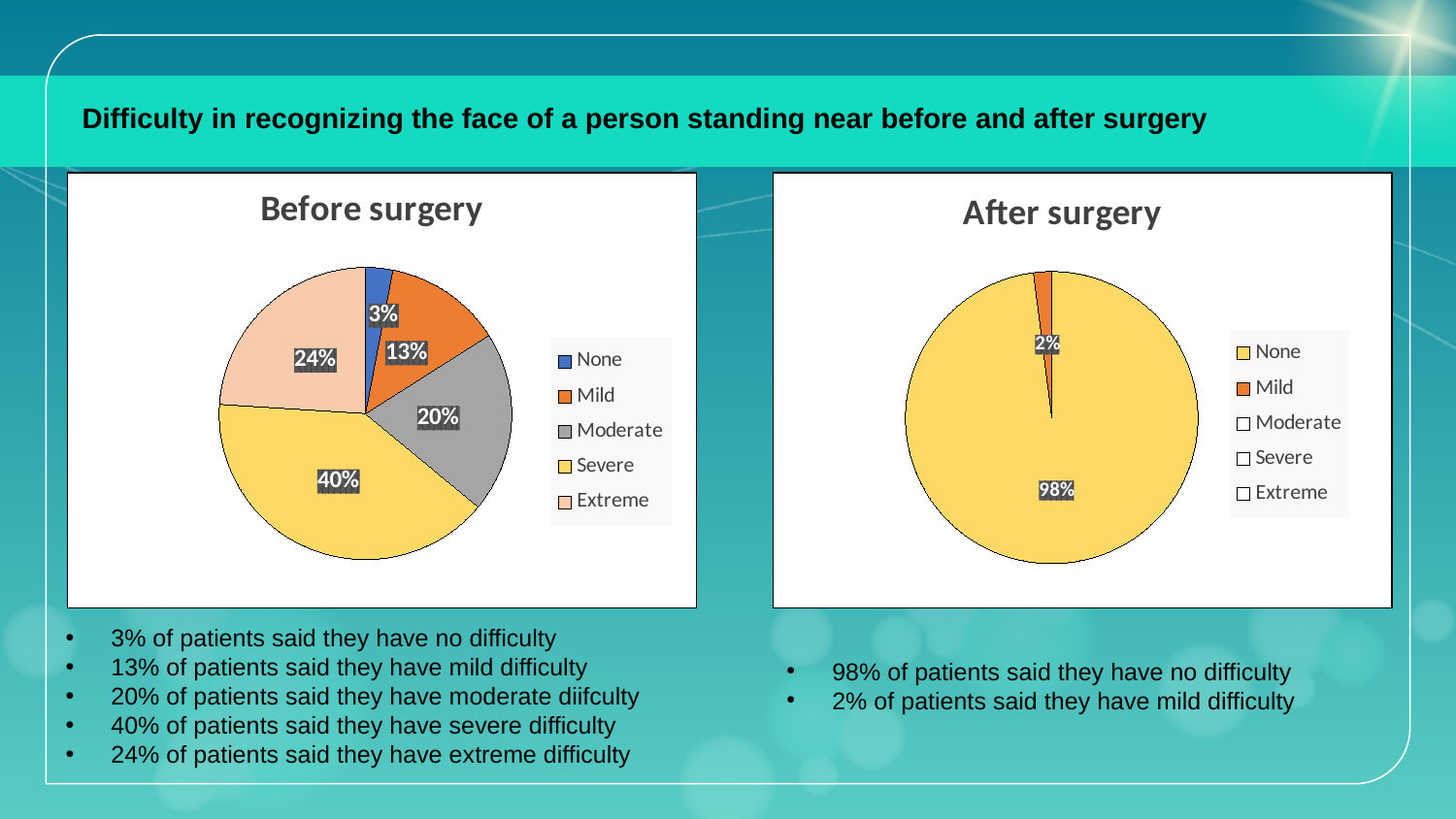
In the 'Before surgery' chart, which is larger, the Moderate share or the Extreme share? Extreme In the 'After surgery' chart, how many slices have a visible data label? 2 In the 'Before surgery' chart, what is the difference between the Extreme and Mild shares? 11% In the 'Before surgery' chart, what percentage of patients reported severe difficulty? 40% What type of chart is the 'After surgery' chart? Pie chart What is the title of the chart on the left side of the slide? Before surgery In the 'After surgery' chart, what percentage of patients reported no difficulty? 98% In the 'Before surgery' chart, which category has the largest share? Severe In the 'Before surgery' chart, which category has the smallest share? None How many categories does the legend of the 'Before surgery' chart list? 5 In the 'Before surgery' chart, what percentage of patients reported moderate difficulty? 20% In the 'After surgery' chart, what percentage of patients reported mild difficulty? 2%